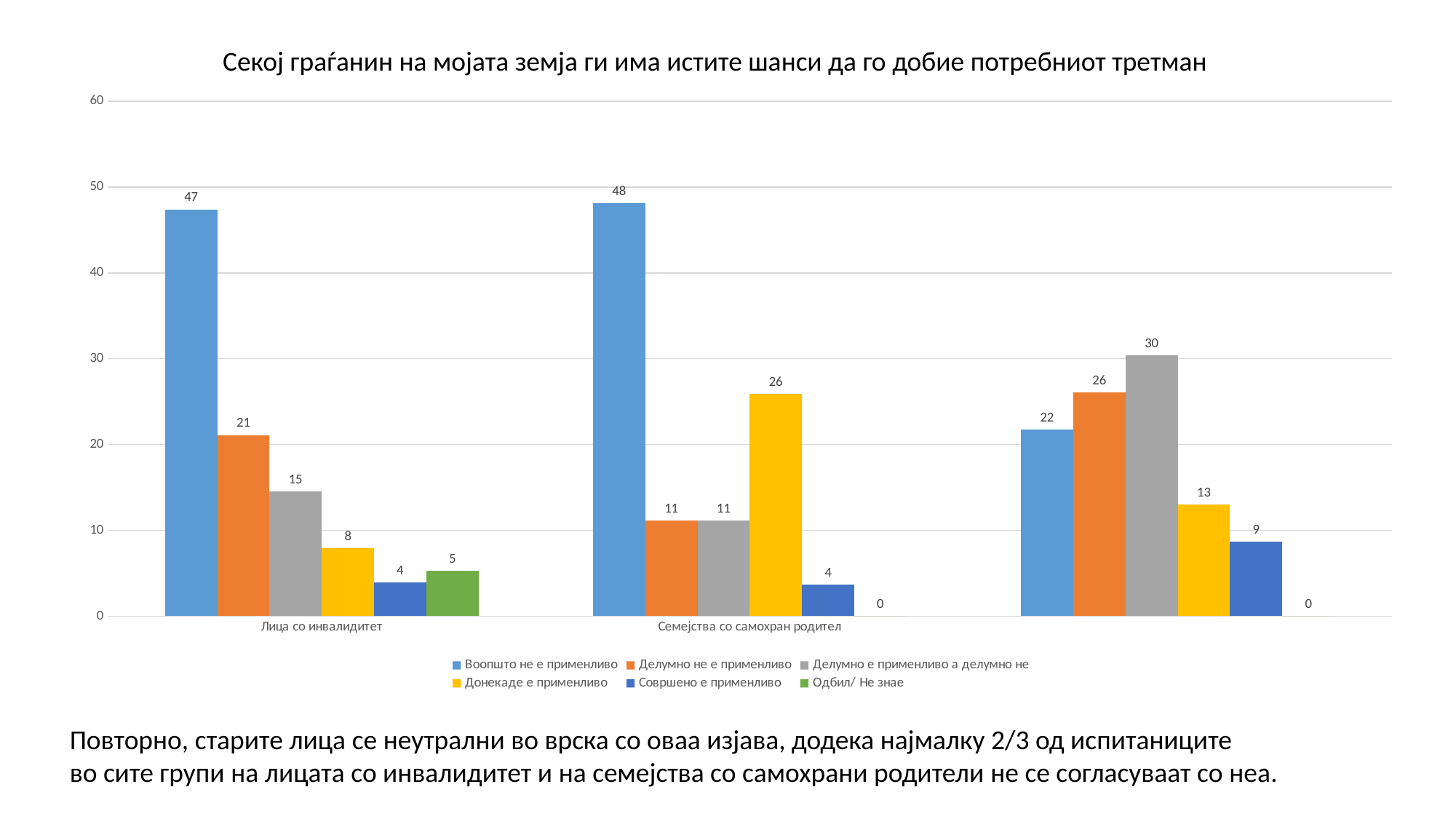
What kind of chart is shown on the slide? bar chart How many series does the legend list? 6 What is the title of the chart? Секој граѓанин на мојата земја ги има истите шанси да го добие потребниот третман How many groups of bars are shown in the chart? 3 Which series has the lowest value in the "Семејства со самохран родител" group? Одбил/ Не знае Which series has the highest value in the "Семејства со самохран родител" group? Воопшто не е применливо What is the value for "Воопшто не е применливо" in the "Лица со инвалидитет" group? 47 Is the value for "Воопшто не е применливо" in the "Семејства со самохран родител" group greater or less than 40? greater In the "Лица со инвалидитет" group, what is the difference between "Воопшто не е применливо" and "Делумно не е применливо"? 26 Which group has the larger value for "Делумно не е применливо": "Лица со инвалидитет" or "Семејства со самохран родител"? Лица со инвалидитет What is the value for "Совршено е применливо" in the "Лица со инвалидитет" group? 4 What is the value for "Донекаде е применливо" in the "Семејства со самохран родител" group? 26